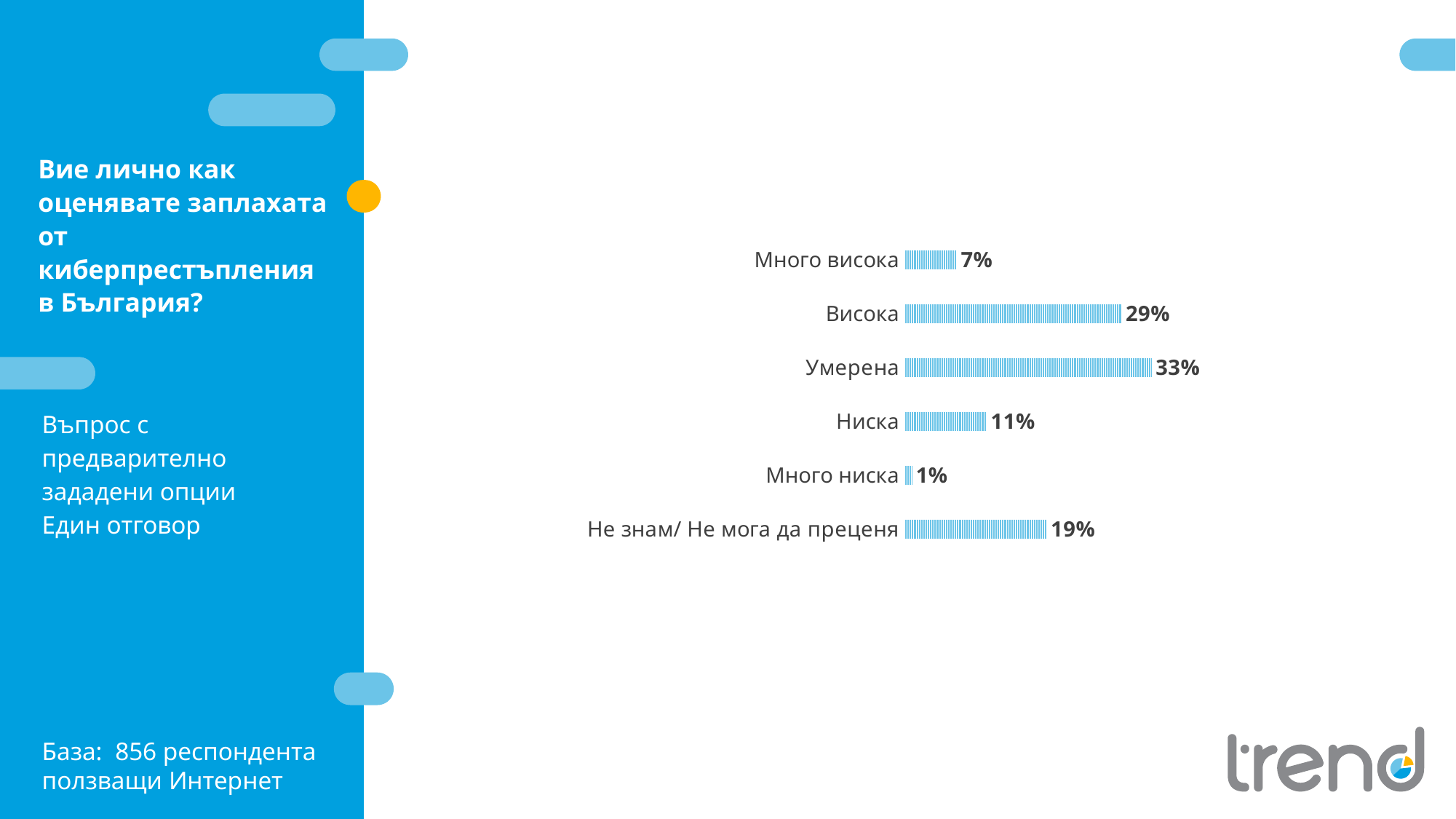
Which category has the highest value? Умерена What is the value for "Висока"? 29% Which category has the lowest value? Много ниска Which is larger, the value for "Не знам/ Не мога да преценя" or the value for "Ниска"? Не знам/ Не мога да преценя What kind of chart is shown on the slide? Bar chart What is the difference between the values for "Ниска" and "Много висока"? 4% What is the value for "Не знам/ Не мога да преценя"? 19% What is the value for "Умерена"? 33% What is the base (number of respondents) stated on the slide? 856 респондента ползващи Интернет What is the difference between the values for "Умерена" and "Висока"? 4% How many categories does the chart show? 6 What is the value for "Много ниска"? 1%